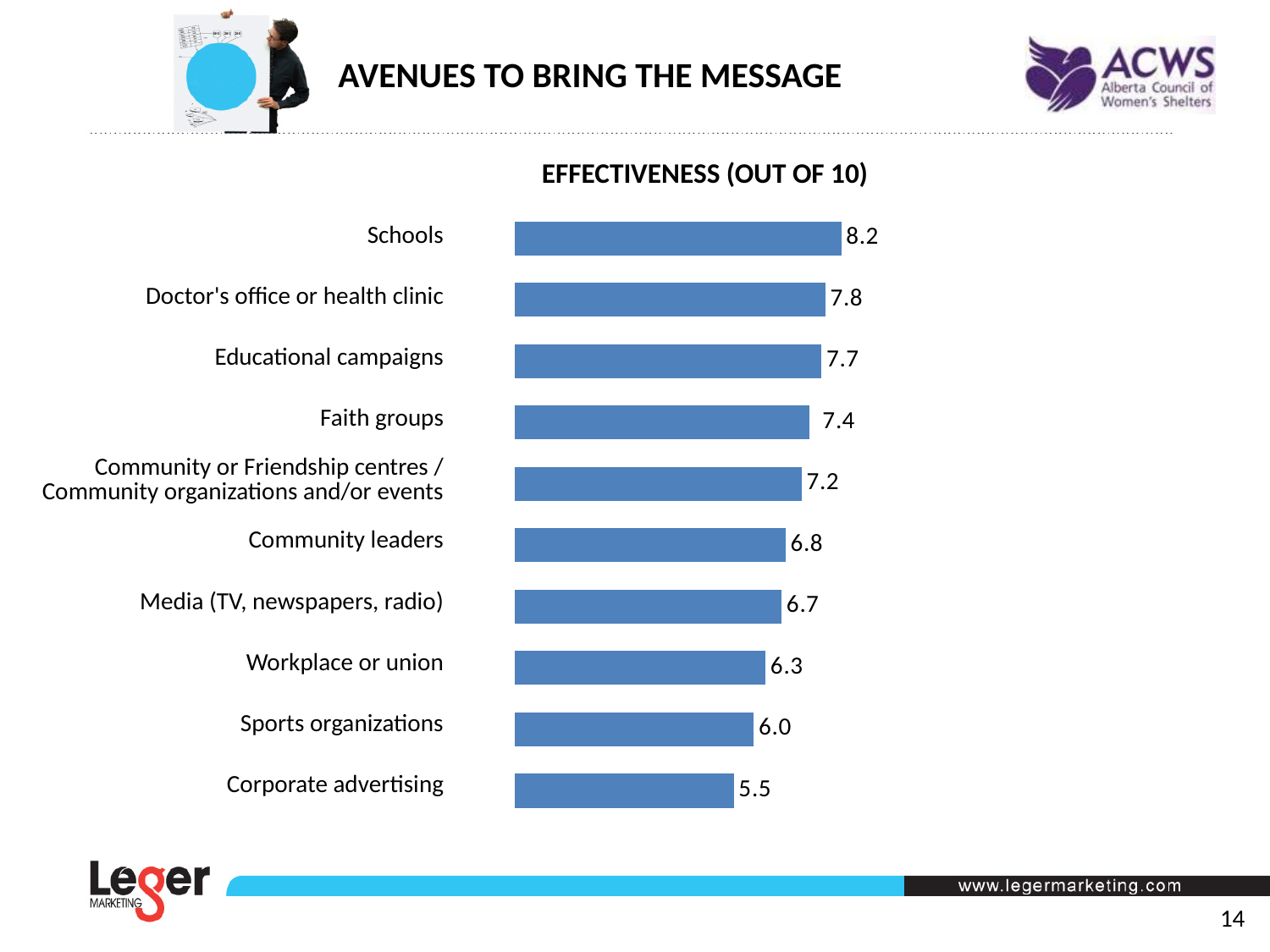
How many avenues are shown in the chart? 10 What is the title of the chart? EFFECTIVENESS (OUT OF 10) Which avenue has the lowest effectiveness score? Corporate advertising What type of chart is shown on the slide? Bar chart Which avenue has the highest effectiveness score? Schools What is the difference between the effectiveness scores for Doctor's office or health clinic and Sports organizations? 1.8 Which has a higher effectiveness score, Educational campaigns or Media (TV, newspapers, radio)? Educational campaigns What is the difference between the effectiveness scores for Schools and Corporate advertising? 2.7 What is the effectiveness score for Faith groups? 7.4 Which has a higher effectiveness score, Community leaders or Sports organizations? Community leaders What is the effectiveness score for Schools? 8.2 What is the effectiveness score for Workplace or union? 6.3